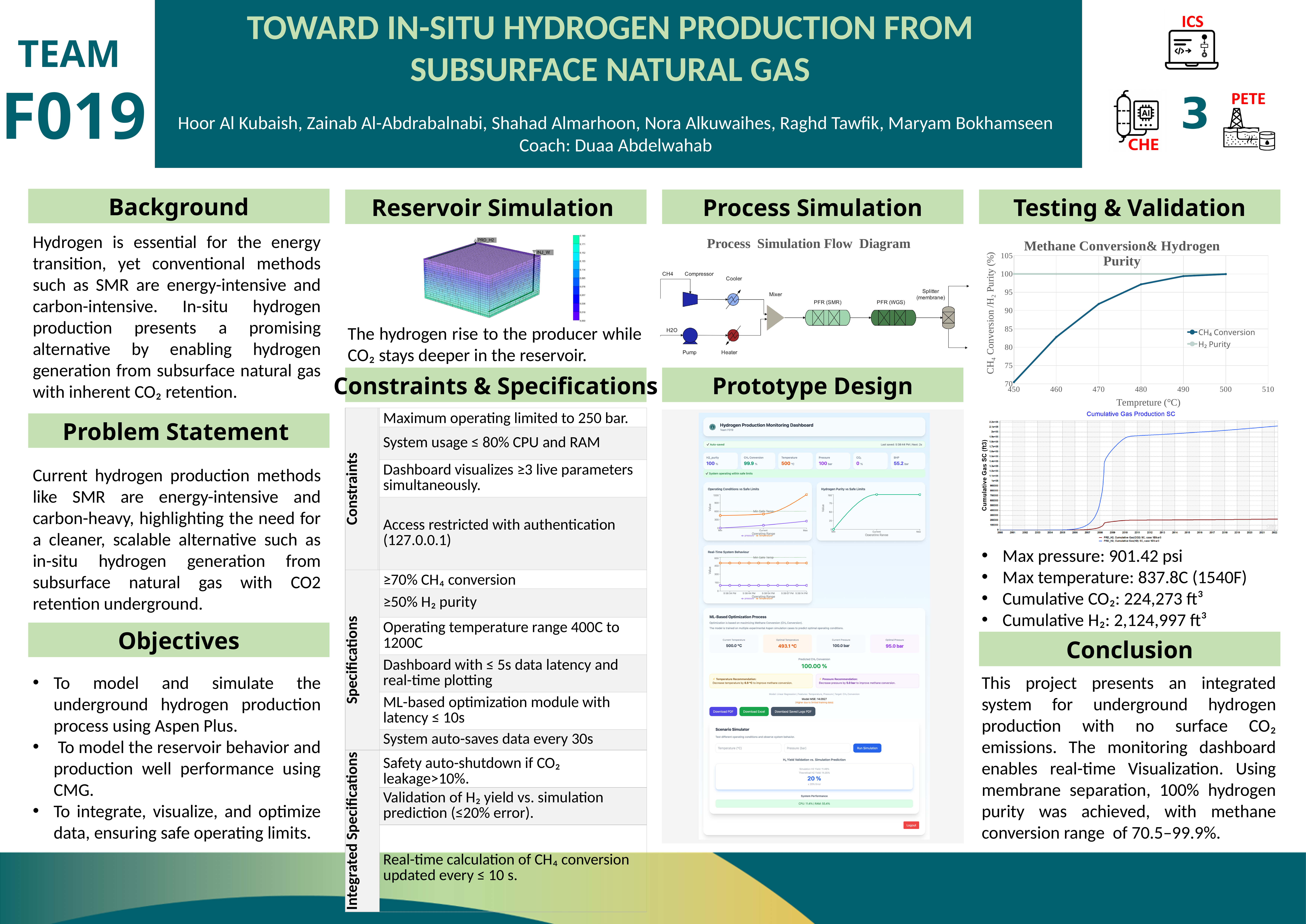
In the "Methane Conversion & Hydrogen Purity" chart, is the CH₄ Conversion value at 500 °C greater or less than 95? greater In the "Methane Conversion & Hydrogen Purity" chart, is the CH₄ Conversion value at 450 °C greater or less than 75? less How many series does the legend of the "Methane Conversion & Hydrogen Purity" chart list? 2 In the "Methane Conversion & Hydrogen Purity" chart, does CH₄ Conversion rise or fall as temperature increases from 450 to 500 °C? rise What kind of chart is the "Methane Conversion & Hydrogen Purity" chart? line chart What is the x-axis label of the "Methane Conversion & Hydrogen Purity" chart? Tempreture (°C) What are the two legend entries in the "Methane Conversion & Hydrogen Purity" chart? CH₄ Conversion and H₂ Purity In the "Methane Conversion & Hydrogen Purity" chart, which series is higher at 460 °C, CH₄ Conversion or H₂ Purity? H₂ Purity In the "Methane Conversion & Hydrogen Purity" chart, at which temperature is CH₄ Conversion lowest? 450 In the "Methane Conversion & Hydrogen Purity" chart, is the CH₄ Conversion value at 460 °C greater or less than 90? less In the "Methane Conversion & Hydrogen Purity" chart, how many temperature points are plotted for the CH₄ Conversion series? 6